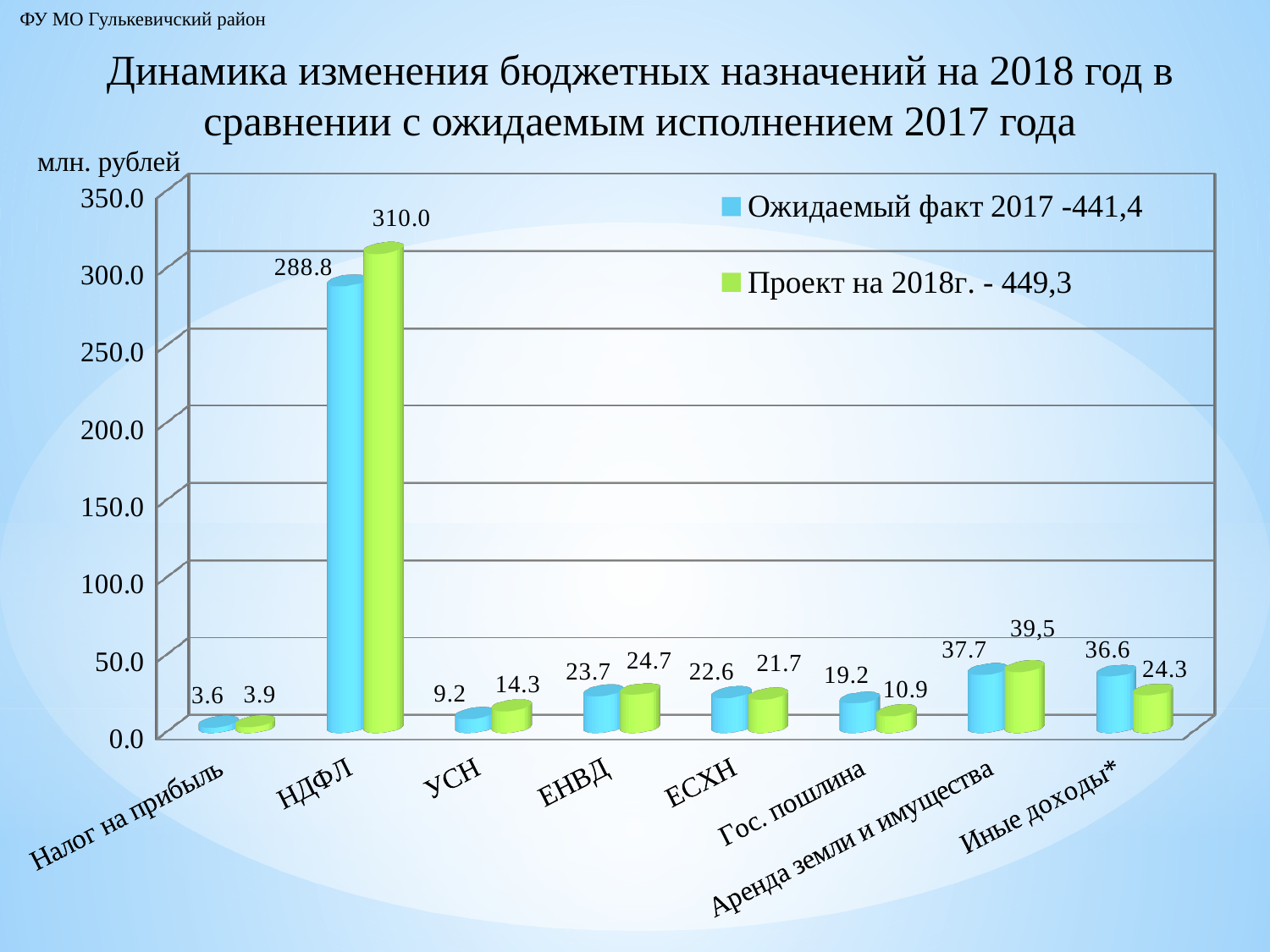
What is the value for НДФЛ in the Проект на 2018г. series? 310.0 How many categories are shown on the x axis? 8 For Иные доходы*, which series has the larger value: Ожидаемый факт 2017 or Проект на 2018г.? Ожидаемый факт 2017 Is the Ожидаемый факт 2017 value for НДФЛ greater or less than 250.0? greater What is the difference between the Проект на 2018г. and Ожидаемый факт 2017 values for НДФЛ? 21.2 What is the value for Гос. пошлина in the Проект на 2018г. series? 10.9 Which category has the lowest value in the Ожидаемый факт 2017 series? Налог на прибыль Which category has the highest value in the Проект на 2018г. series? НДФЛ How many series does the legend list? 2 What type of chart is shown on the slide? bar chart What is the value for НДФЛ in the Ожидаемый факт 2017 series? 288.8 What is the value for Иные доходы* in the Ожидаемый факт 2017 series? 36.6